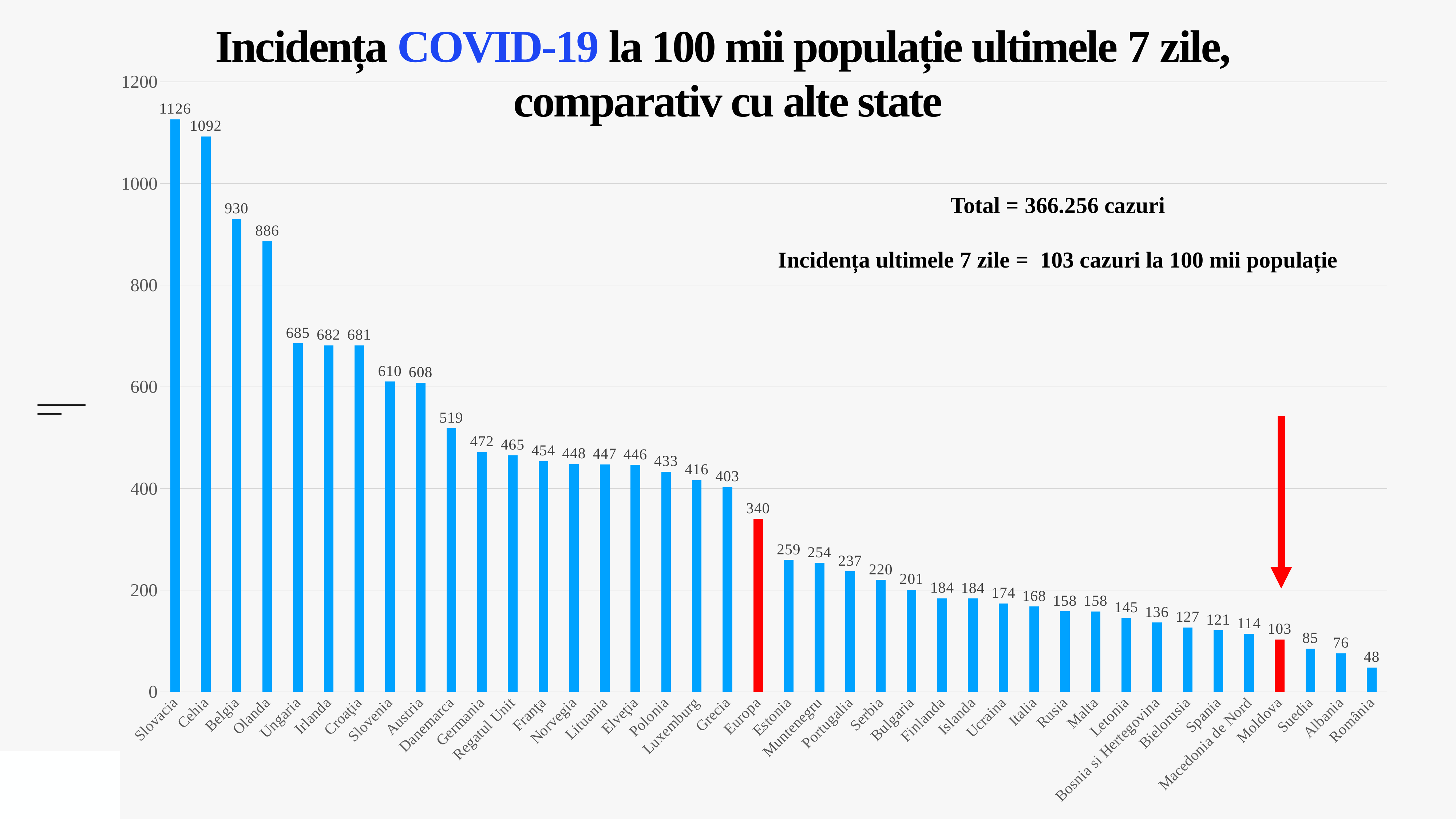
Which two bars are coloured red instead of blue? Europa and Moldova What is the difference between the values for Europa and Moldova? 237 What is the value for Germania? 472 Which country has the lowest value? România Is the value for Danemarca greater or less than 600? less Which has a larger value, Belgia or Olanda? Belgia What is the difference between the values for Slovacia and Cehia? 34 What is the value for Moldova? 103 How many countries/categories are shown on the chart? 40 Which country has the highest value? Slovacia What is the value for Europa? 340 What kind of chart is shown on the slide? bar chart